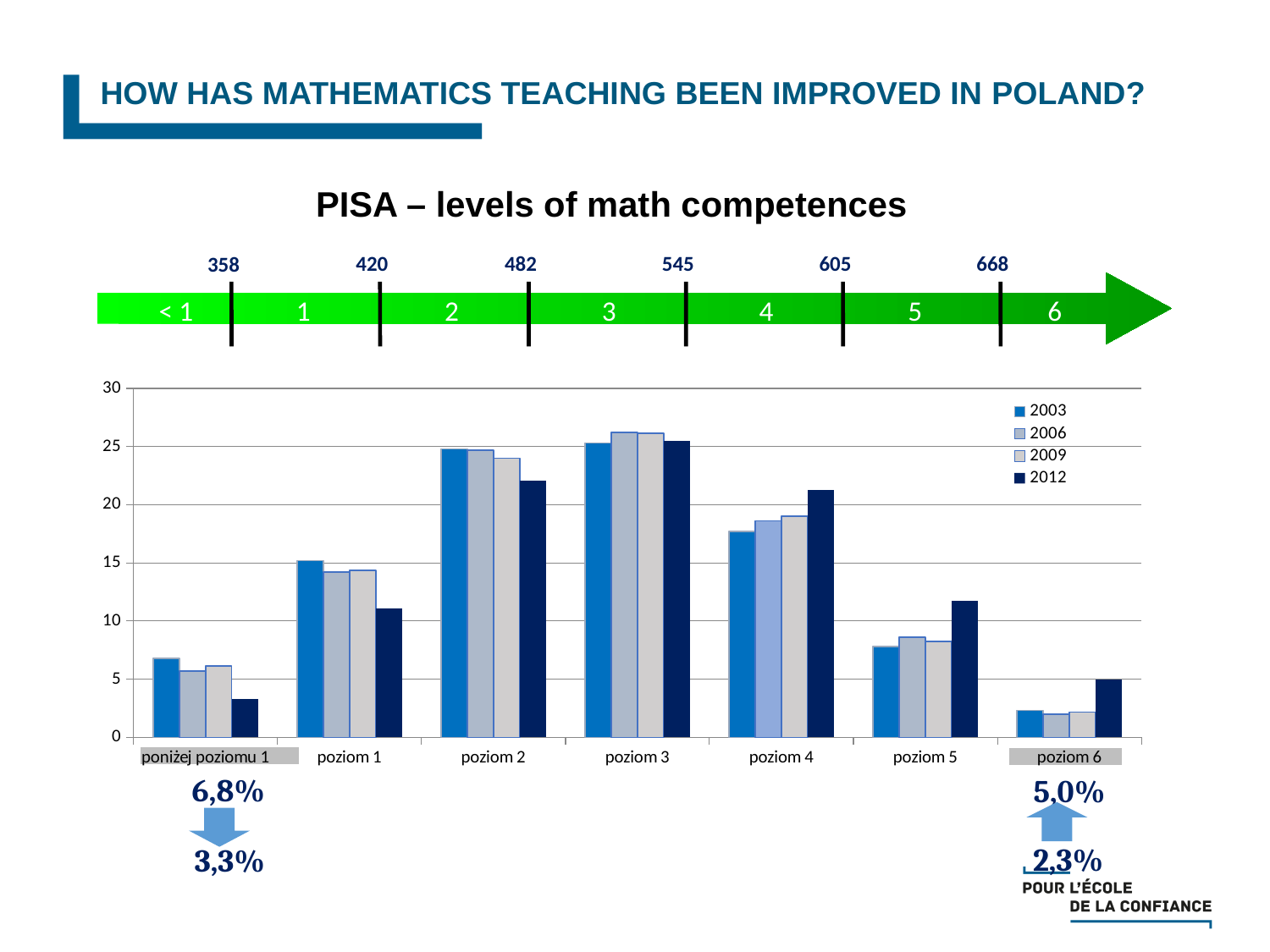
For poziom 2, which is larger: the 2003 value or the 2012 value? 2003 Is the 2012 value for poziom 2 greater or less than 25? less For poziom 4, do the values rise or fall from 2003 to 2012? rise How many categories are shown along the x axis of the chart? 7 How many series does the chart legend list? 4 Which category has the highest value for the 2012 series? poziom 3 For poziom 5, which is larger: the 2003 value or the 2012 value? 2012 Is the 2012 value for poziom 1 greater or less than 15? less What two percentages are annotated below the poniżej poziomu 1 category? 6,8% and 3,3% Which category has the lowest value for the 2003 series? poziom 6 Is the 2012 value for poziom 4 greater or less than 20? greater What kind of chart is shown on the slide? bar chart